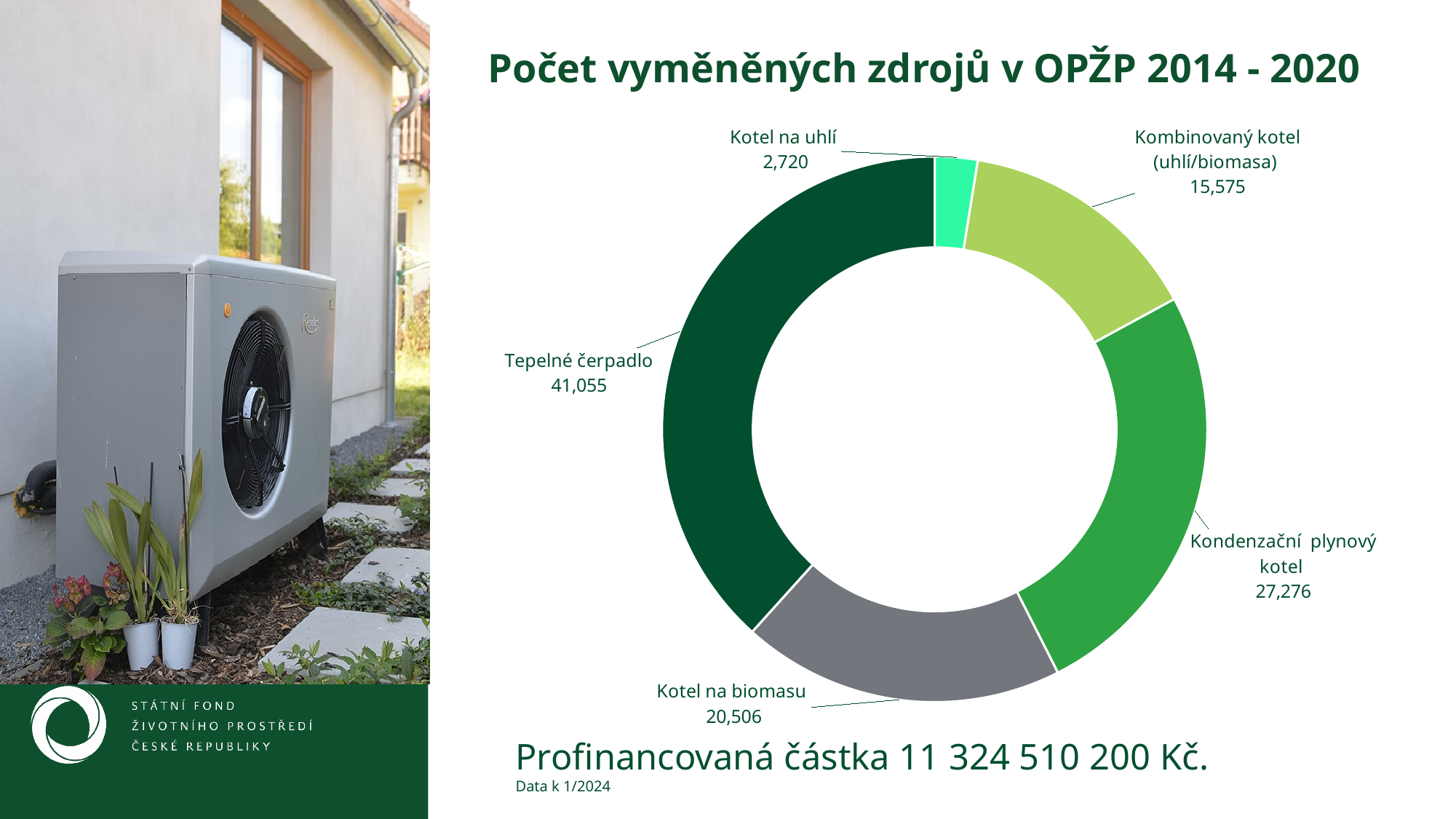
What is the value for Kotel na biomasu? 20,506 Which is larger, the value for Kondenzační plynový kotel or the value for Kotel na biomasu? Kondenzační plynový kotel What is the value for Kombinovaný kotel (uhlí/biomasa)? 15,575 What is the value for Tepelné čerpadlo? 41,055 Which category has the highest value? Tepelné čerpadlo What is the value for Kondenzační plynový kotel? 27,276 How many categories does the chart show? 5 What is the title of the chart? Počet vyměněných zdrojů v OPŽP 2014 - 2020 What is the difference between the values for Tepelné čerpadlo and Kondenzační plynový kotel? 13,779 Which category has the lowest value? Kotel na uhlí What kind of chart is shown on the slide? doughnut chart What is the value for Kotel na uhlí? 2,720